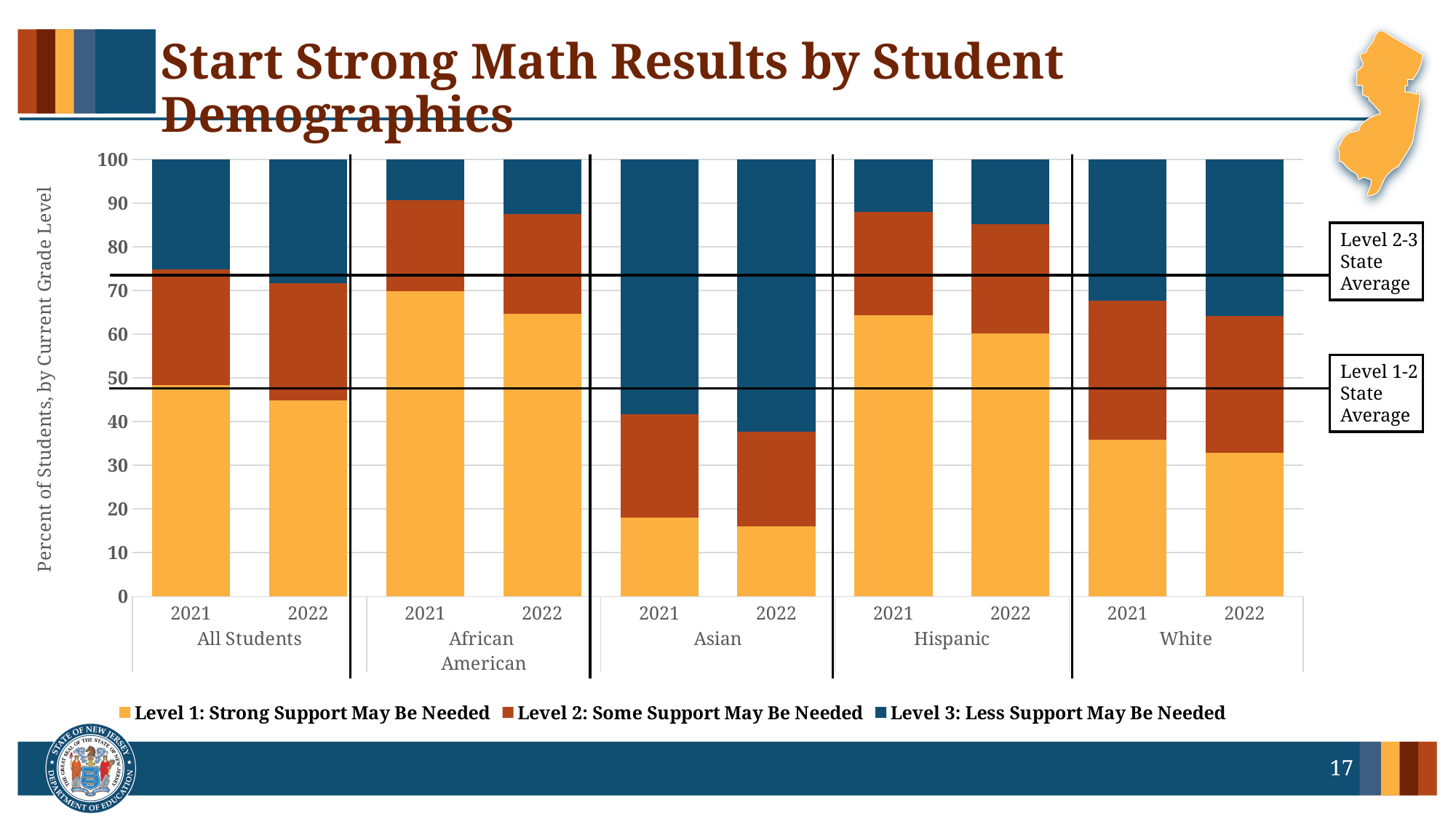
Which demographic group has the smallest Level 1 share in 2021? Asian How many series does the legend list? 3 Is the Level 1 value for Asian students in 2021 greater or less than 20? less What do the two horizontal black lines across the chart represent? Level 2-3 State Average and Level 1-2 State Average Is the Level 1 value for Hispanic students in 2022 greater or less than 50? greater What kind of chart is shown on the slide? Stacked bar chart Is the Level 1 value for White students in 2022 greater or less than 40? less Which is larger, the Level 1 share for Hispanic students in 2021 or for White students in 2021? Hispanic 2021 Does the Level 1 share for All Students rise or fall from 2021 to 2022? Falls How many bars are plotted in the chart in total? 10 How many student demographic groups are shown along the x axis? 5